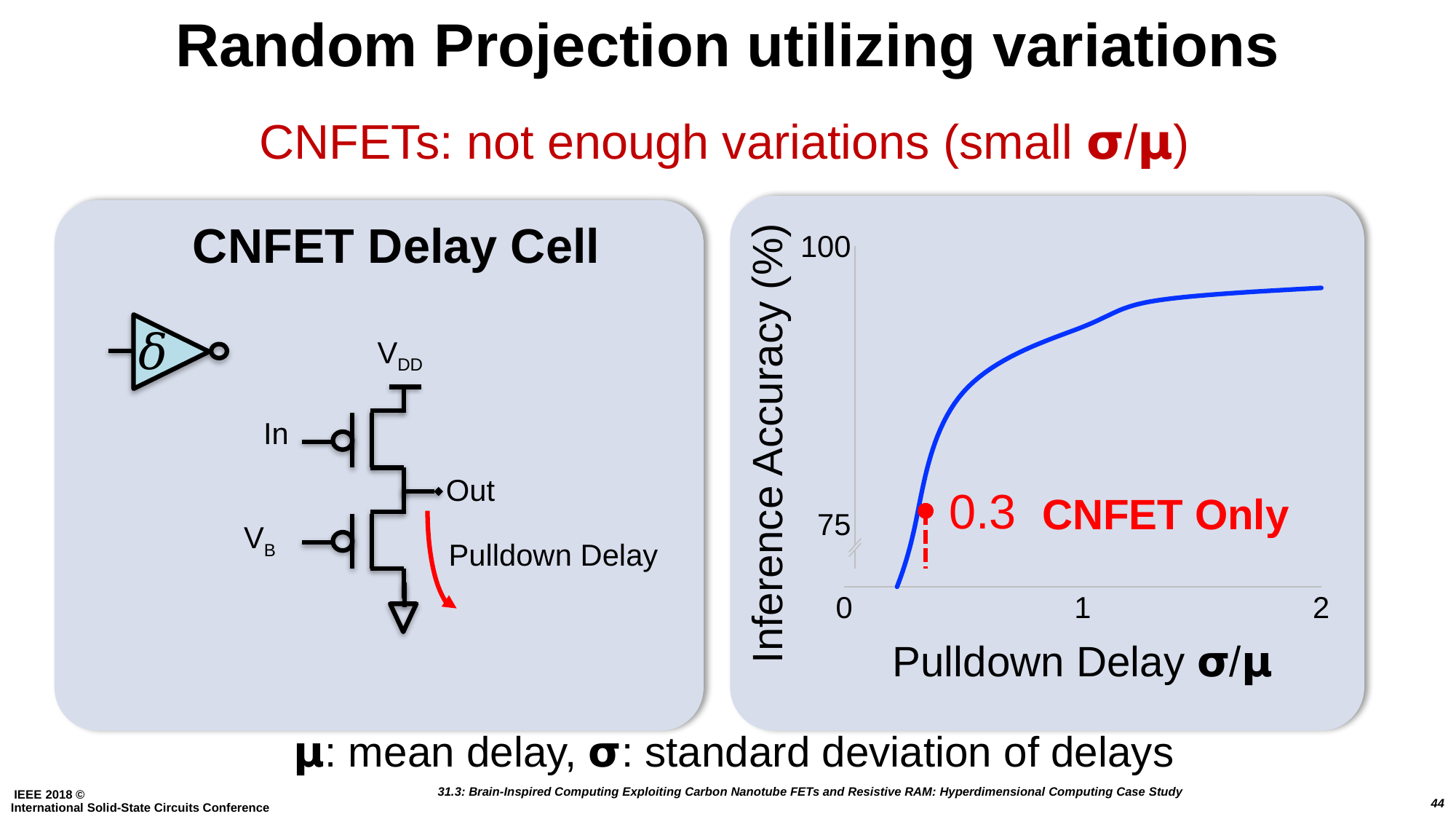
Which has higher inference accuracy: Pulldown Delay σ/μ = 0.3 or σ/μ = 2? σ/μ = 2 At what Pulldown Delay σ/μ value is the 'CNFET Only' point marked on the chart? 0.3 What is the y-axis label of the chart? Inference Accuracy (%) What is the x-axis label of the chart? Pulldown Delay σ/μ Is the inference accuracy at Pulldown Delay σ/μ = 2 greater or less than 75? greater Is the inference accuracy at Pulldown Delay σ/μ = 2 greater or less than 100? less What is the highest tick value shown on the y axis of the chart? 100 How many lines (series) are plotted on the chart? 1 Is the inference accuracy at Pulldown Delay σ/μ = 1 greater or less than 75? greater Does inference accuracy rise or fall as Pulldown Delay σ/μ increases along the x axis? rise What kind of chart is shown on the right side of the slide? line chart